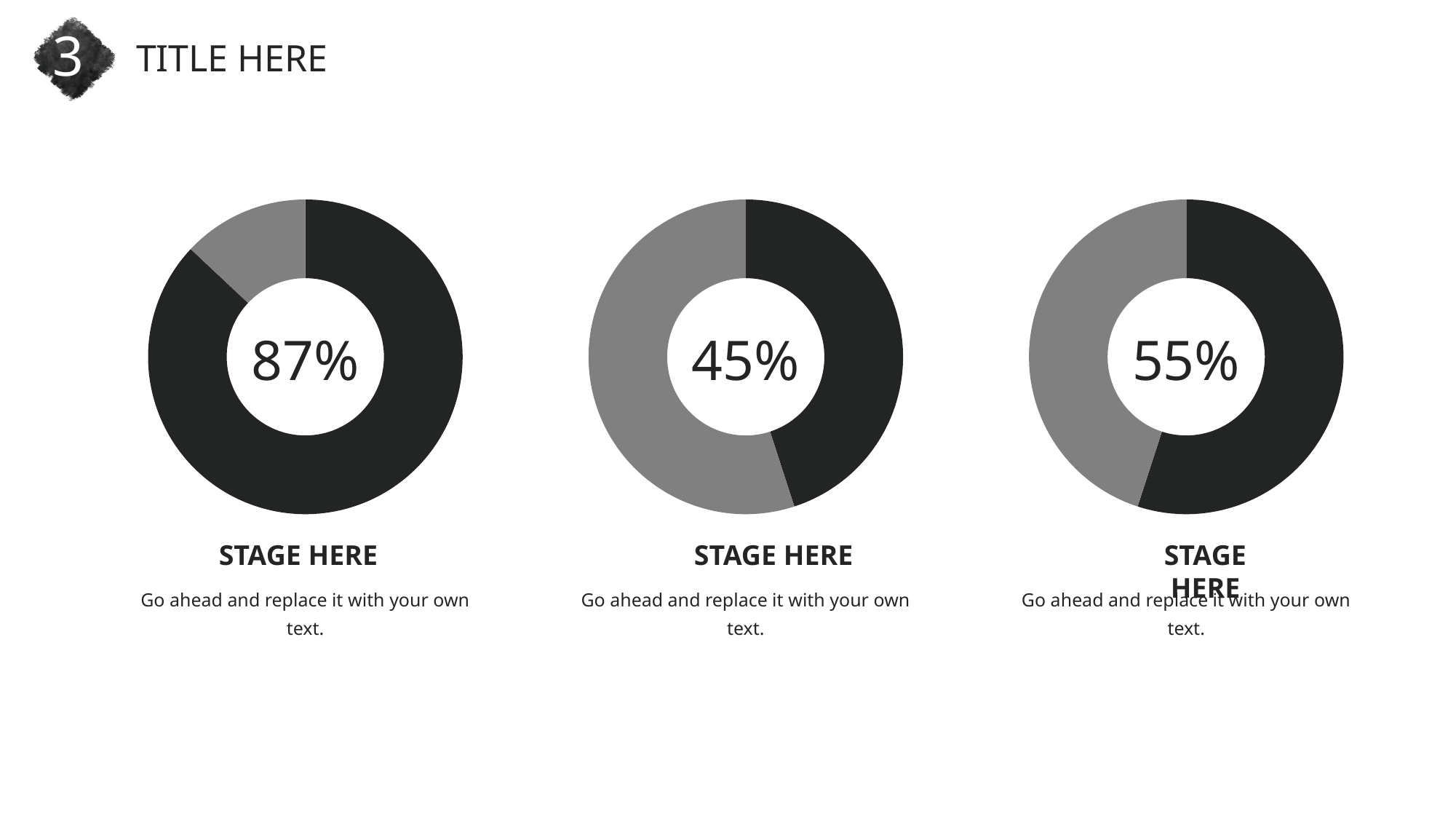
Which of the three donut charts shows the lowest percentage? The middle chart (45%) What is the difference between the percentage in the left donut chart and the percentage in the middle donut chart? 42% What label appears beneath each donut chart? STAGE HERE Is the value shown in the middle donut chart greater or less than 50%? less What percentage is shown in the centre of the left donut chart? 87% What kind of chart is used to display the percentages on this slide? Donut chart What percentage is shown in the centre of the right donut chart? 55% What percentage is shown in the centre of the middle donut chart? 45% Which of the three donut charts shows the highest percentage? The left chart (87%) Is the percentage in the right donut chart larger or smaller than the percentage in the middle donut chart? Larger What is the difference between the percentage in the right donut chart and the percentage in the middle donut chart? 10% How many donut charts are on the slide? 3